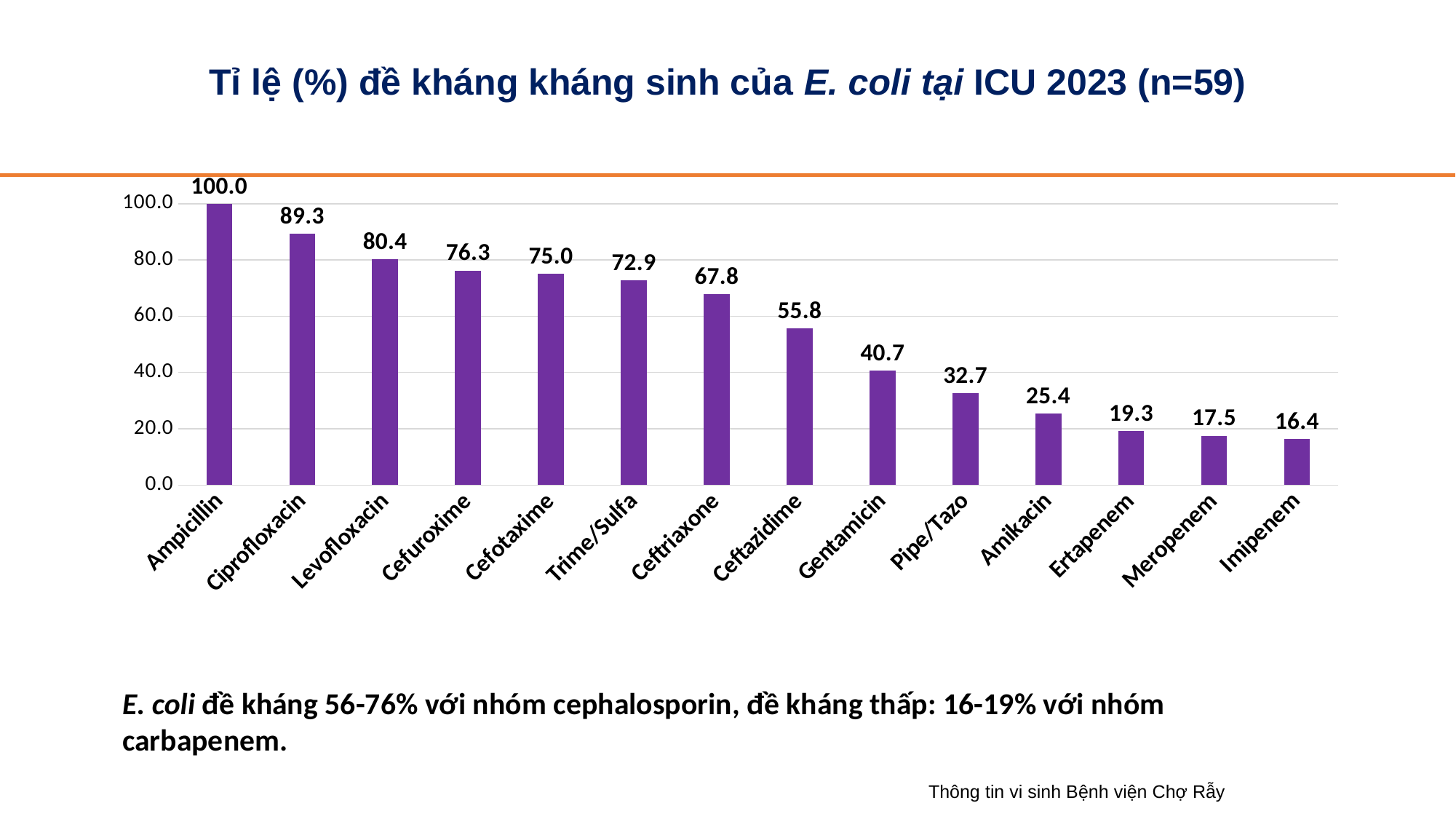
Which has a higher resistance rate, Cefuroxime or Ceftriaxone? Cefuroxime How many antibiotics are shown on the x axis? 14 What is the resistance rate for Ciprofloxacin? 89.3 Which antibiotic has the lowest resistance rate? Imipenem Which antibiotic has the highest resistance rate? Ampicillin What is the title of the chart? Tỉ lệ (%) đề kháng kháng sinh của E. coli tại ICU 2023 (n=59) Do the values rise or fall from left to right along the x axis? fall What is the resistance rate for Ceftazidime? 55.8 What kind of chart is shown on the slide? bar chart Is the value for Pipe/Tazo greater or less than 40.0? less What is the resistance rate for Meropenem? 17.5 What is the difference between the resistance rates for Levofloxacin and Gentamicin? 39.7